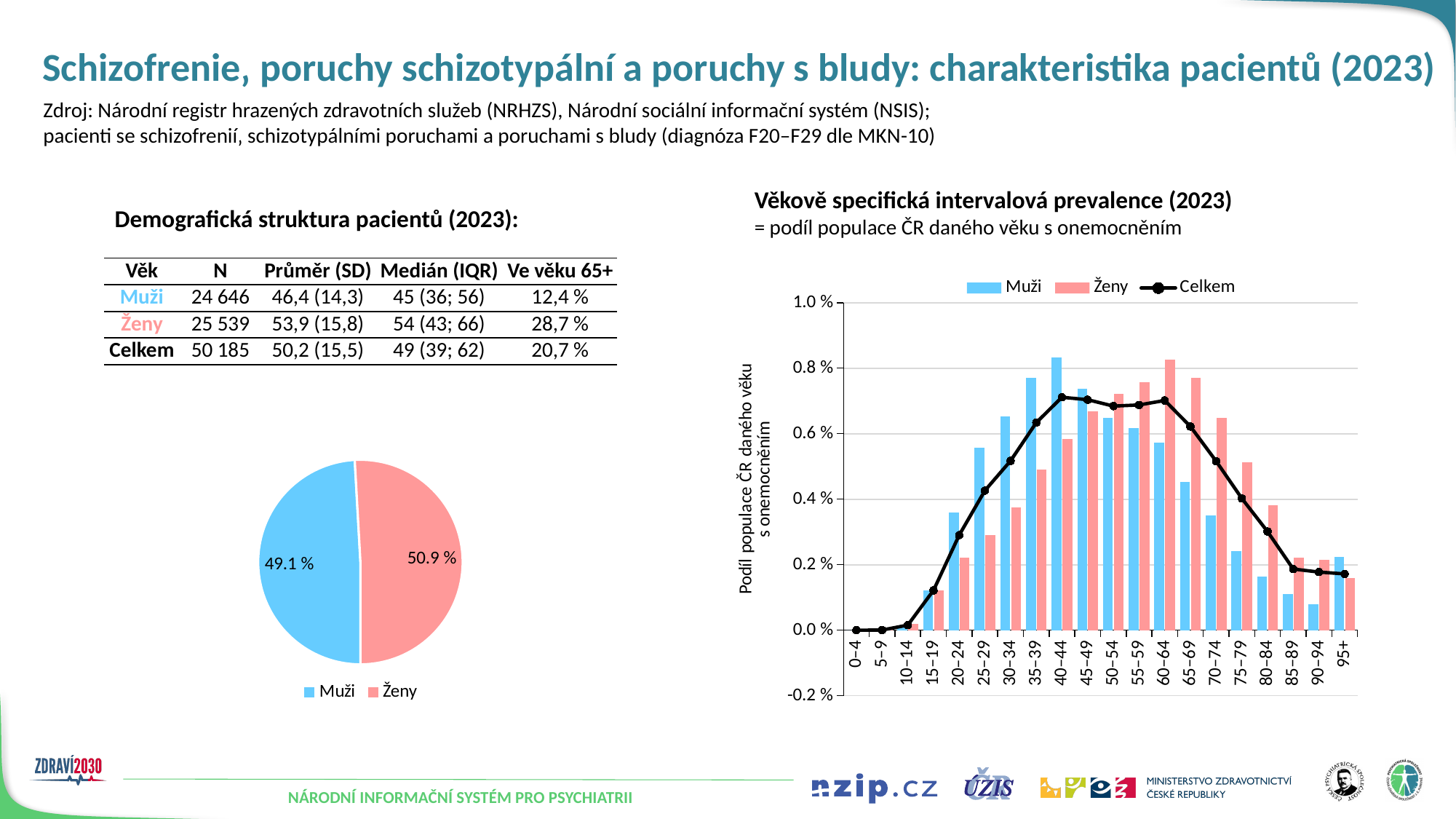
In the pie chart on the left, which slice is larger, Muži or Ženy? Ženy In the chart 'Věkově specifická intervalová prevalence (2023)', how many series does the legend list? 3 In the chart 'Věkově specifická intervalová prevalence (2023)', how many age categories are shown on the x axis? 20 How many slices does the pie chart on the left have? 2 In the chart 'Věkově specifická intervalová prevalence (2023)', does the Celkem line rise or fall from the 60–64 age group to the 95+ age group? Falls In the pie chart on the left, what share of patients are Ženy? 50.9 % In the chart 'Věkově specifická intervalová prevalence (2023)', is the value for Muži in the 35–39 age group greater or less than 0.6 %? greater In the pie chart on the left, what share of patients are Muži? 49.1 % In the chart 'Věkově specifická intervalová prevalence (2023)', which age group has the highest value for Ženy? 60–64 In the chart 'Věkově specifická intervalová prevalence (2023)', is the value for Muži in the 20–24 age group greater or less than 0.4 %? less In the chart 'Věkově specifická intervalová prevalence (2023)', which age group has the highest value for Muži? 40–44 What kind of chart is the chart on the left of the slide? Pie chart